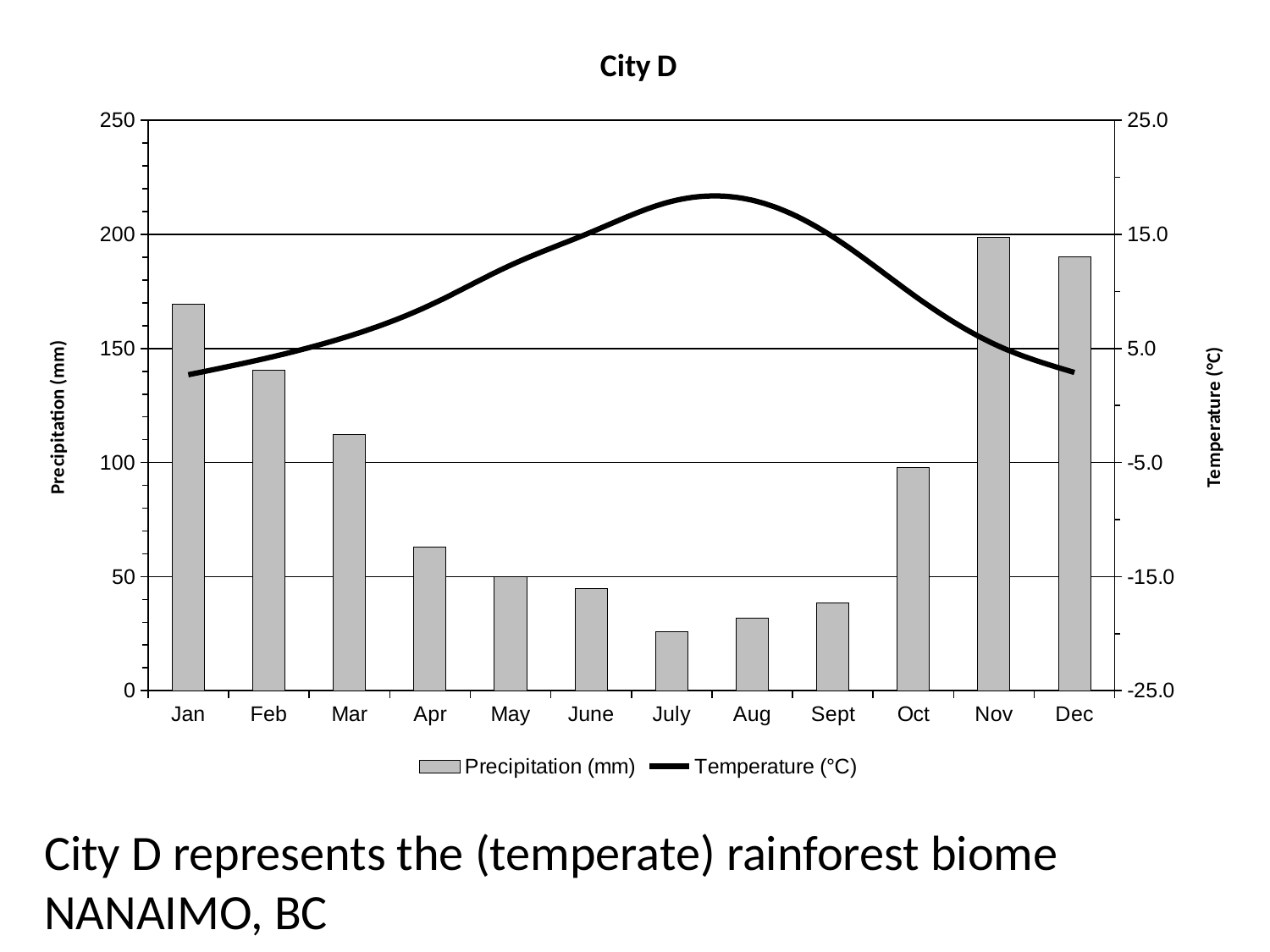
Is the temperature for July greater or less than 15.0? greater What is the title of the chart? City D Is the precipitation for Jan greater or less than 150? greater Does precipitation rise or fall from Jan to July? fall Is the precipitation for July greater or less than 50? less Which month has higher precipitation, Mar or Oct? Mar Which month has the lowest precipitation? July How many months are shown on the x axis? 12 How many series does the legend list? 2 What kind of chart is this? Combined bar and line chart